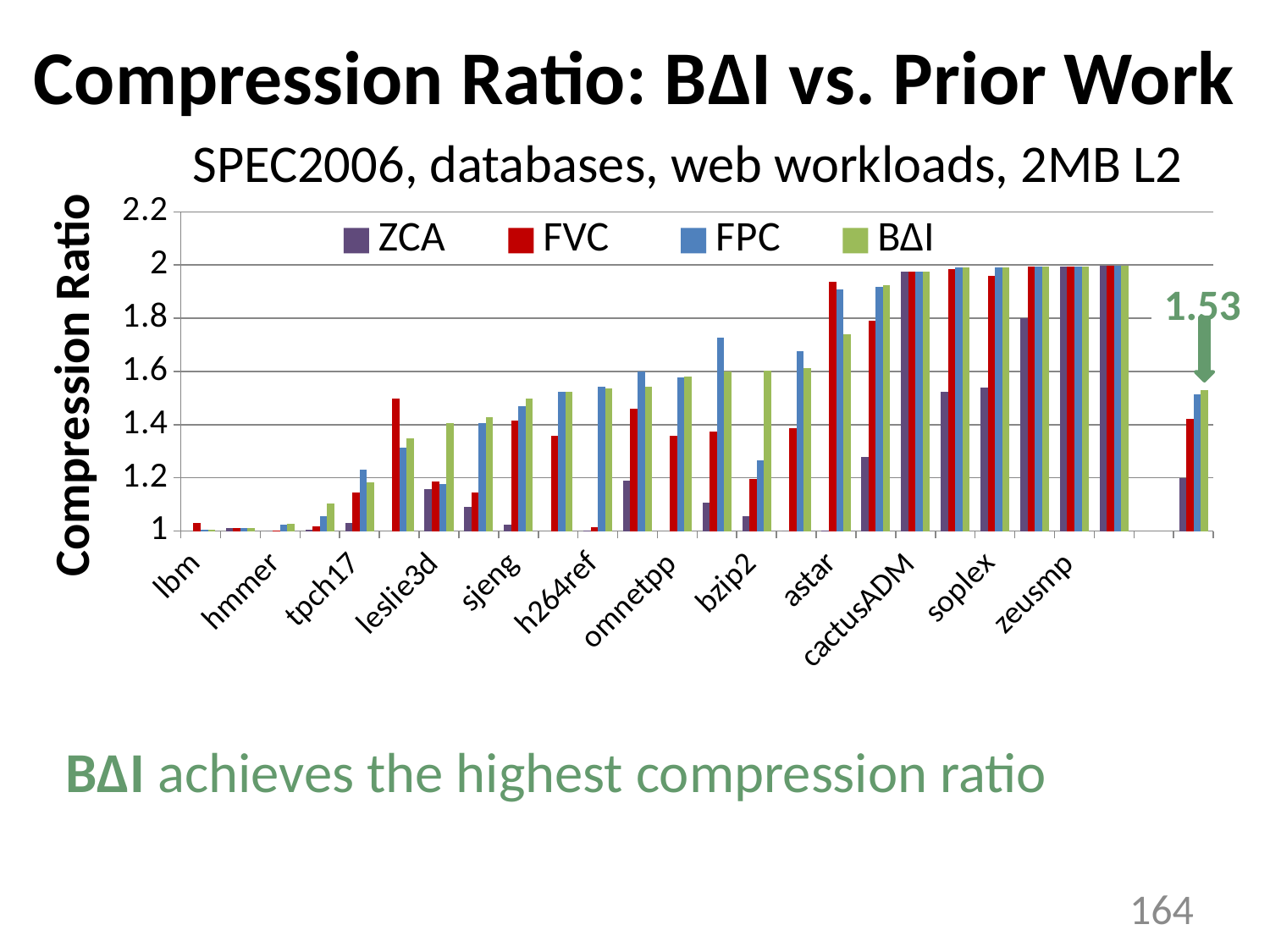
What is the highest tick value shown on the chart's vertical axis? 2.2 Is the ZCA value in the rightmost group of bars greater or less than 1.4? less What value is annotated above the rightmost group of bars in the chart? 1.53 Is the FVC value in the rightmost group of bars greater or less than 1.2? greater Is the BΔI value for lbm greater or less than 1.2? less What is the title of the chart's vertical axis? Compression Ratio How many category labels are printed along the x axis of the chart? 12 What are the series names listed in the chart's legend? ZCA, FVC, FPC, BΔI What kind of chart is shown on the slide? bar chart In the rightmost group of bars, which is larger, the BΔI value or the ZCA value? BΔI How many series does the chart's legend list? 4